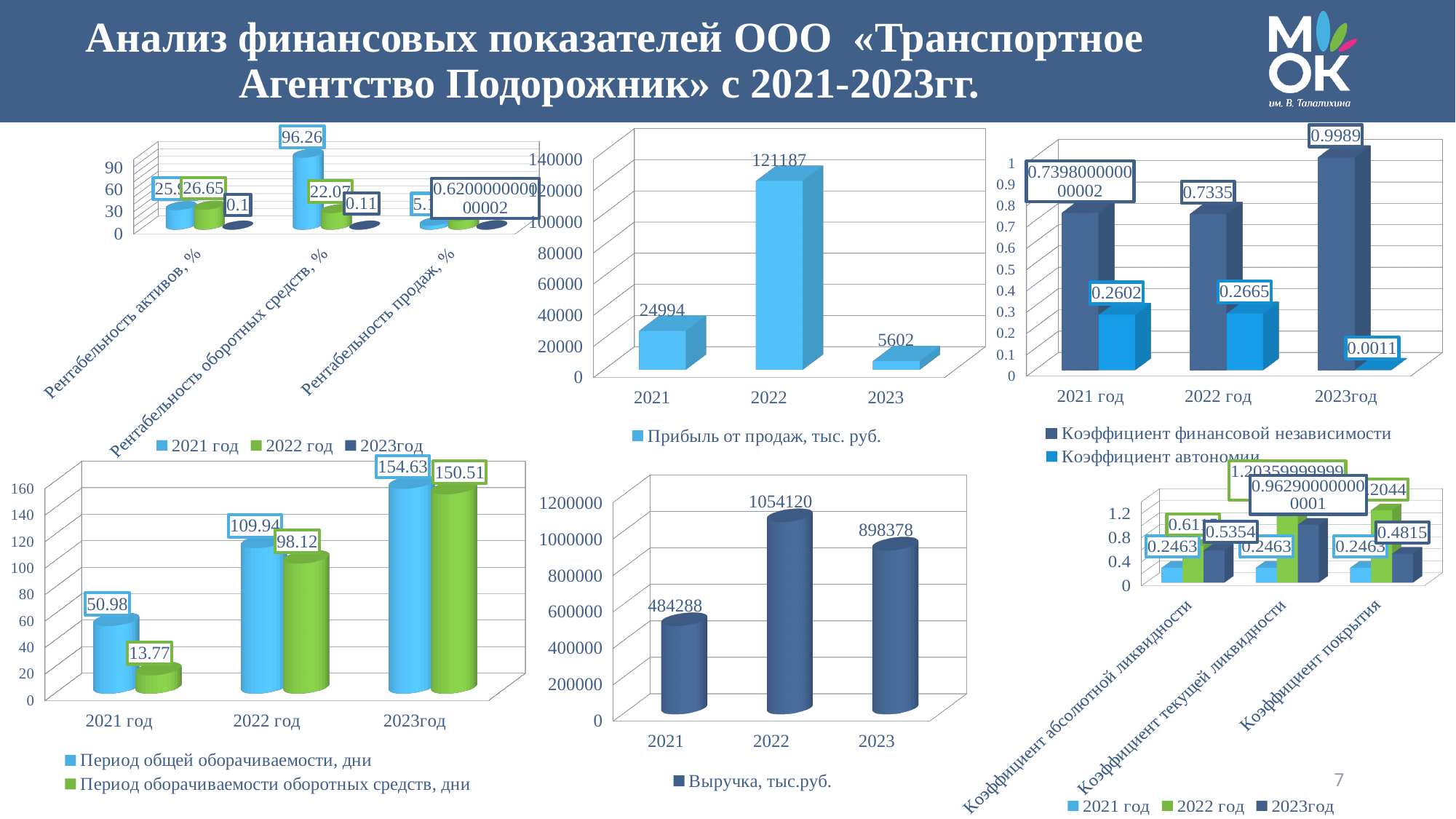
In the chart with legend 'Период общей оборачиваемости, дни', does the Период общей оборачиваемости rise or fall from 2021 год to 2023год? rise In the chart with legend 'Выручка, тыс.руб.', is the value for 2023 greater or less than 800000? greater In the chart with legend 'Период общей оборачиваемости, дни', what is the difference between Период общей оборачиваемости and Период оборачиваемости оборотных средств for 2023год? 4.12 In the chart with legend 'Выручка, тыс.руб.', which year has the highest value? 2022 In the chart with legend 'Прибыль от продаж, тыс. руб.', what is the difference between the 2022 and 2021 values? 96193 In the chart with legend 'Прибыль от продаж, тыс. руб.', which year has the lowest value? 2023 In the chart with legend 'Период общей оборачиваемости, дни', what is the Период оборачиваемости оборотных средств for 2021 год? 13.77 In the chart with legend 'Выручка, тыс.руб.', what is the value for 2021? 484288 In the chart with categories Коэффициент абсолютной ликвидности, Коэффициент текущей ликвидности and Коэффициент покрытия, how many series does the legend list? 3 In the chart with legend 'Коэффициент финансовой независимости' and 'Коэффициент автономии', what is the Коэффициент финансовой независимости for 2023год? 0.9989 In the chart with legend 'Прибыль от продаж, тыс. руб.', what is the value for 2022? 121187 In the chart with legend 'Коэффициент финансовой независимости' and 'Коэффициент автономии', what is the Коэффициент автономии for 2022 год? 0.2665